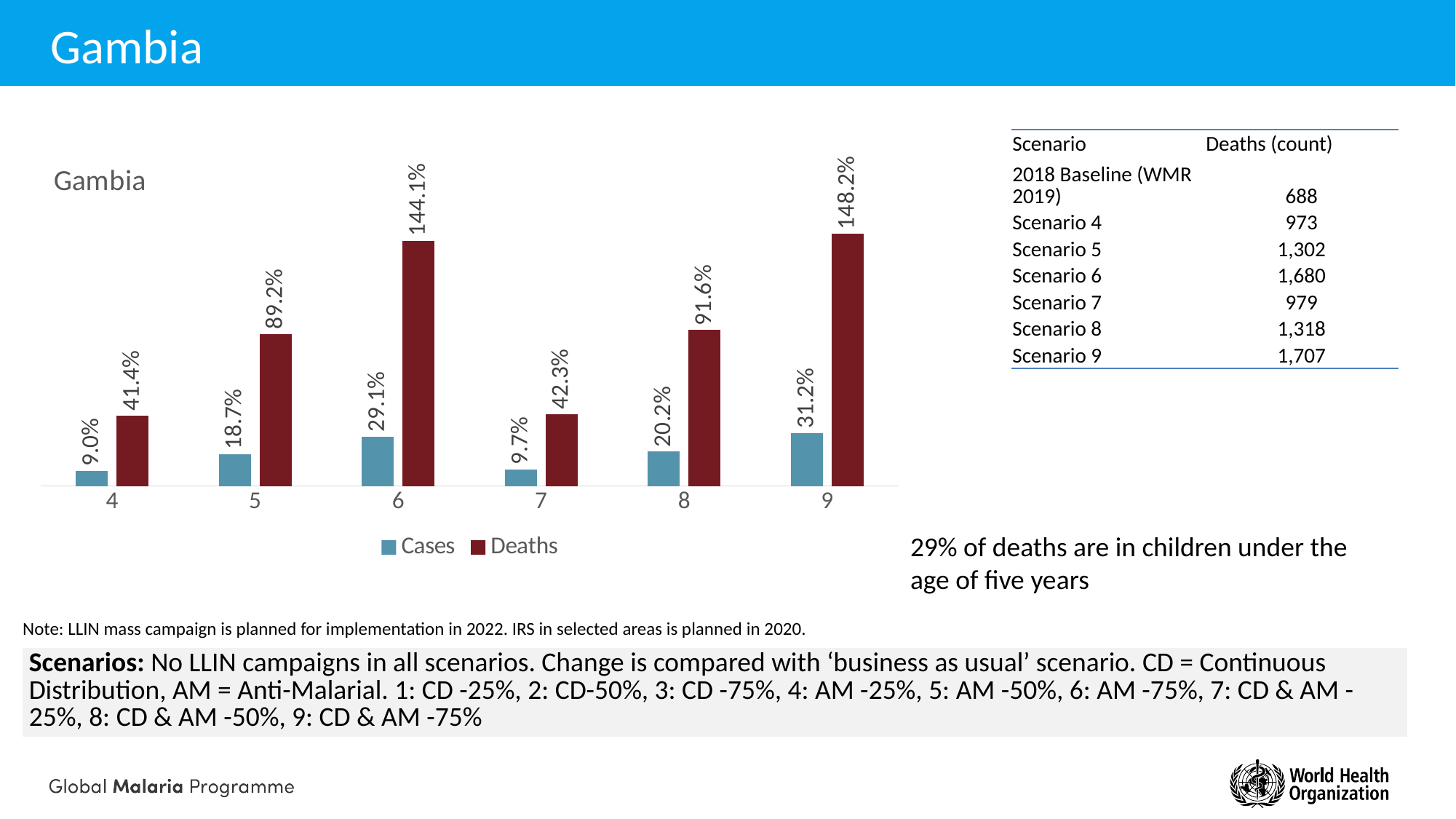
How many series does the chart legend list? 2 Which scenario has the highest Deaths value? 9 What is the value of Cases for scenario 9? 31.2% Which is larger, the Cases value for scenario 5 or for scenario 8? scenario 8 What is the value of Cases for scenario 4? 9.0% What kind of chart is shown on the slide? bar chart What is the value of Deaths for scenario 7? 42.3% What is the value of Deaths for scenario 6? 144.1% What are the two series named in the chart legend? Cases and Deaths How many scenarios are shown on the x axis of the chart? 6 Which scenario has the lowest Cases value? 4 What is the difference between the Deaths values for scenario 9 and scenario 6? 4.1%